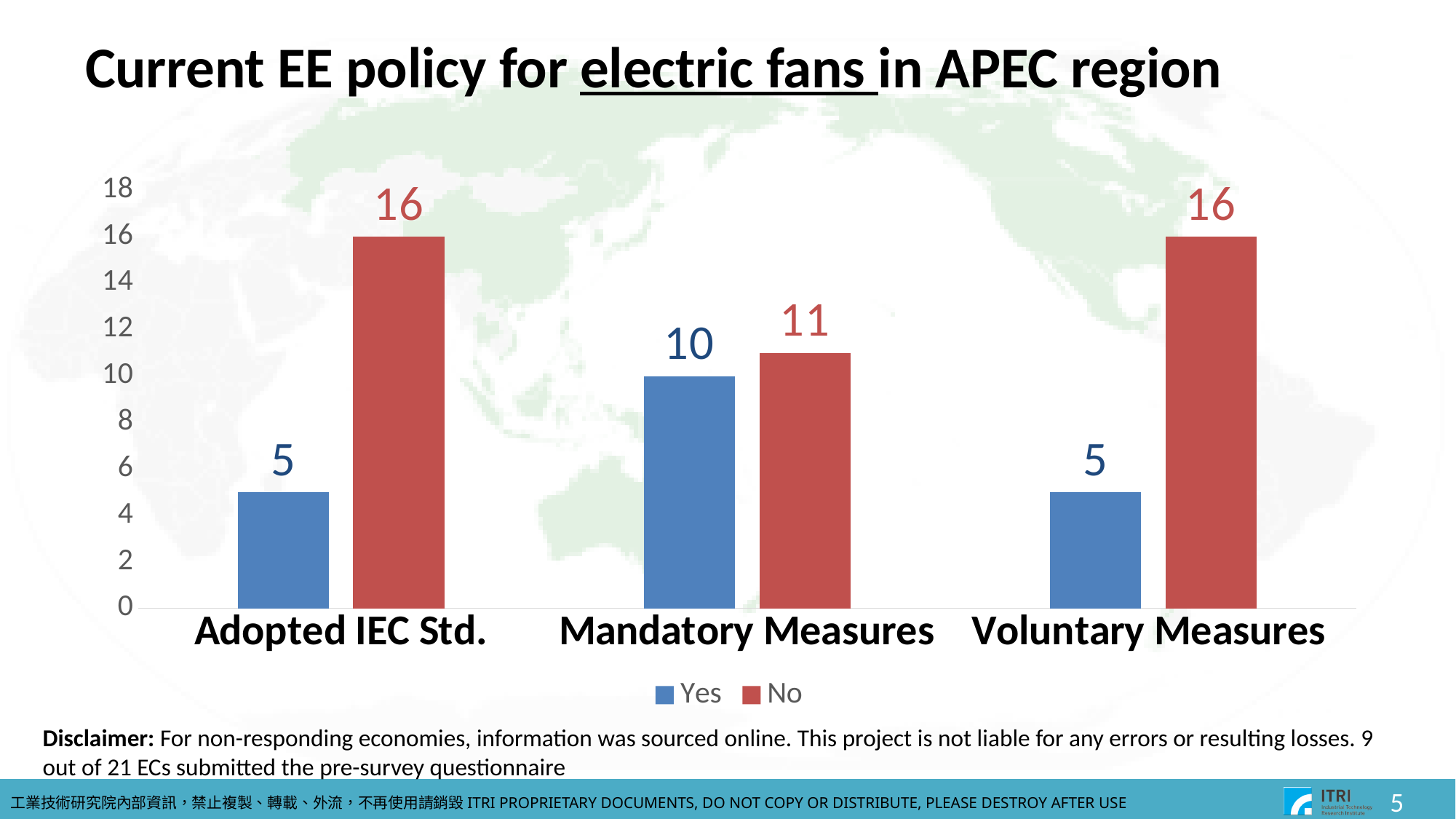
How many series does the legend list? 2 Which category has the highest value for Yes? Mandatory Measures Is the value for No in Voluntary Measures greater or less than 14? greater What is the difference between the No and Yes values for Adopted IEC Std.? 11 What is the value for Yes in the Adopted IEC Std. category? 5 Which is larger for Mandatory Measures, Yes or No? No What is the value for No in the Mandatory Measures category? 11 How many categories are shown on the x axis? 3 Which category has the lowest value for No? Mandatory Measures What kind of chart is shown on the slide? Bar chart What is the value for Yes in the Voluntary Measures category? 5 What colour represents the No series? Red